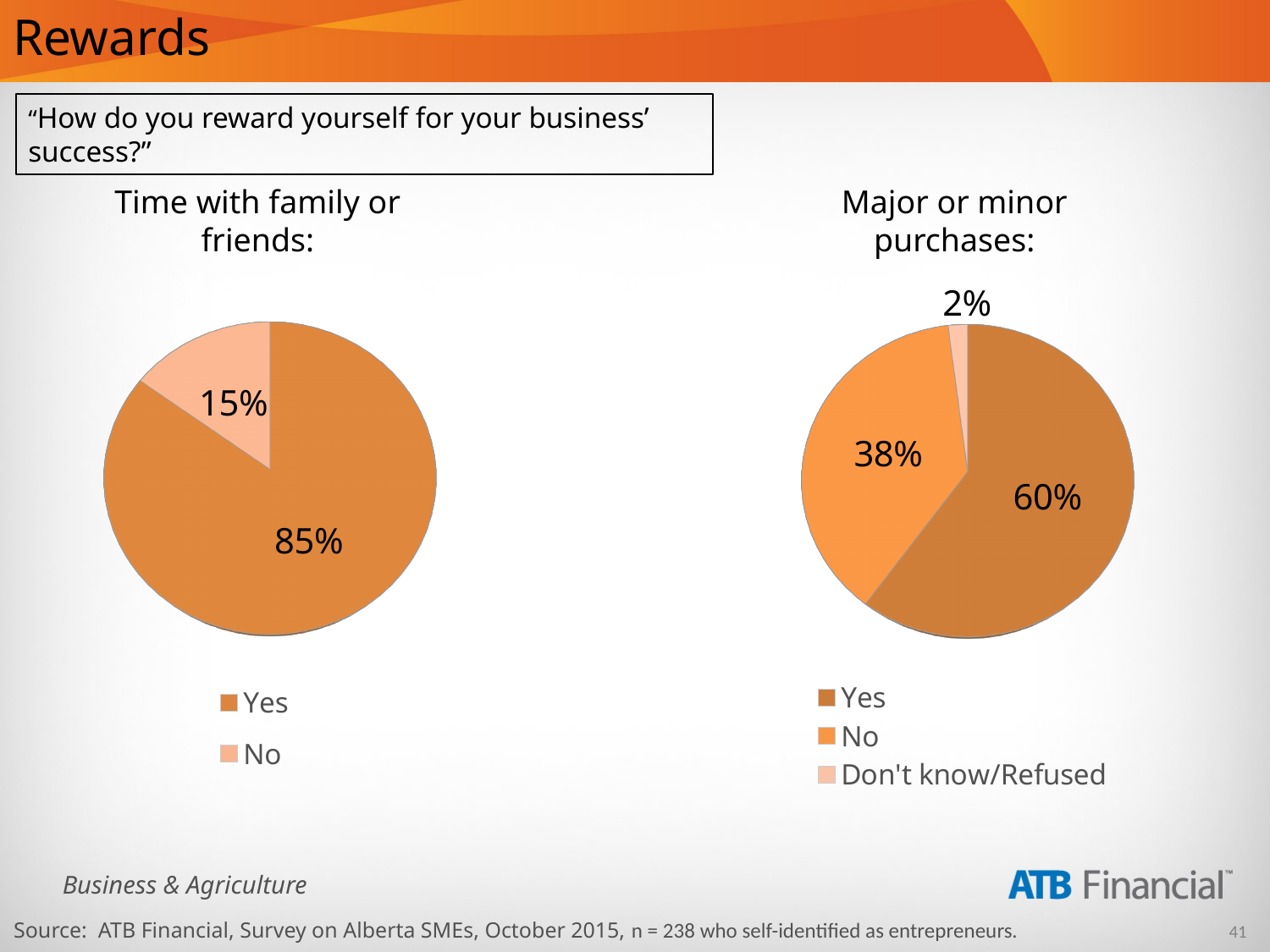
In the 'Major or minor purchases' pie chart, what percentage answered Yes? 60% In the 'Time with family or friends' pie chart, what percentage answered Yes? 85% In the 'Major or minor purchases' pie chart, what percentage is Don't know/Refused? 2% In the 'Time with family or friends' pie chart, what percentage answered No? 15% How many categories does the legend of the 'Major or minor purchases' pie chart list? 3 In the 'Time with family or friends' pie chart, what is the difference between the Yes and No shares? 70% What type of chart is used for 'Time with family or friends'? Pie chart In the 'Major or minor purchases' pie chart, which response has the smallest share? Don't know/Refused In the 'Major or minor purchases' pie chart, which response has the largest share? Yes Which is larger: the Yes share in the 'Time with family or friends' chart or the Yes share in the 'Major or minor purchases' chart? Time with family or friends In the 'Major or minor purchases' pie chart, what percentage answered No? 38% In the 'Major or minor purchases' pie chart, what is the difference between the Yes and No shares? 22%